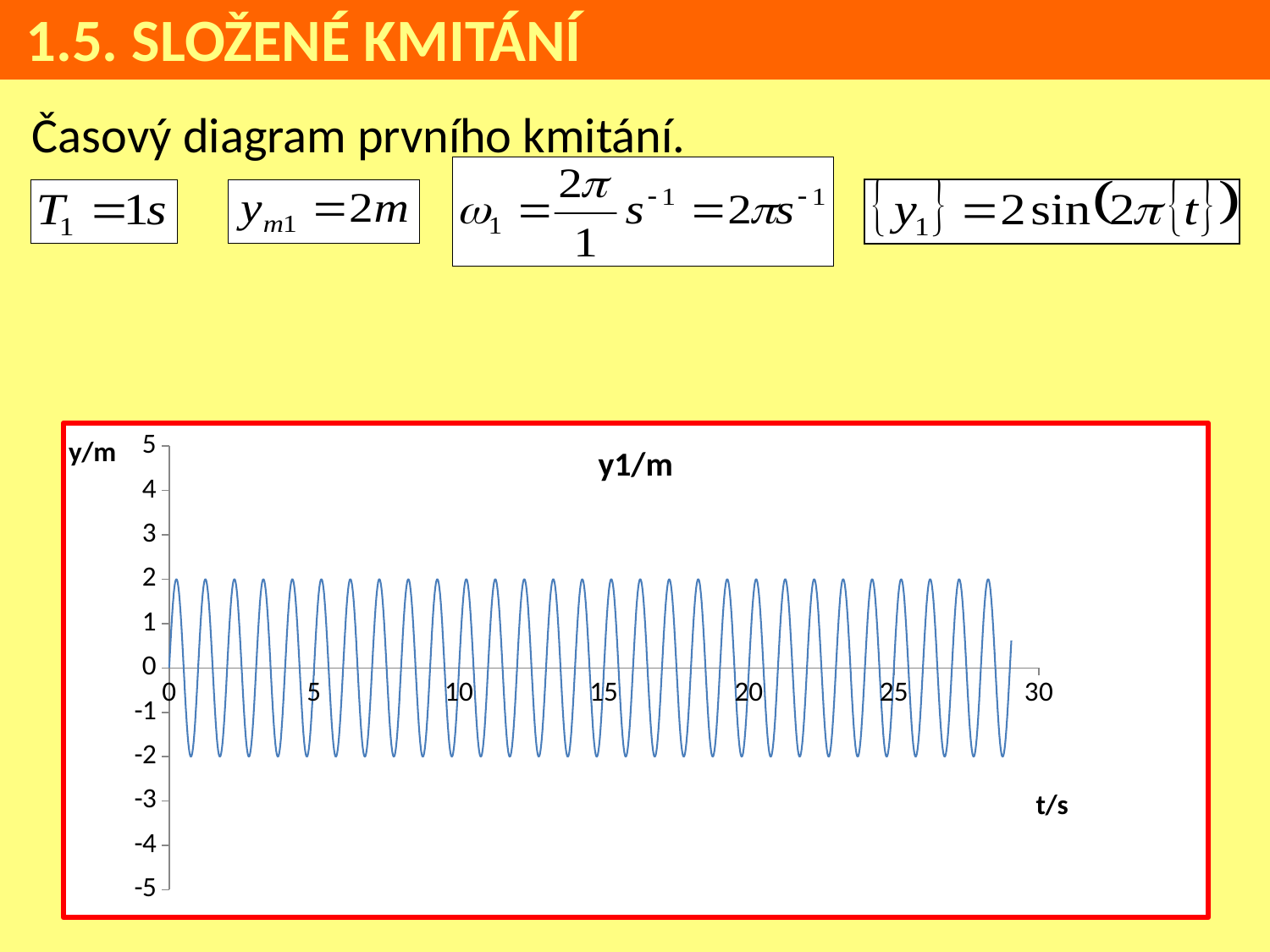
What kind of chart is shown on the slide? line chart What label is shown on the horizontal axis of the chart? t/s Is the peak value of the plotted line greater or less than 1? greater Does the amplitude of the plotted oscillation rise, fall, or stay constant along the x axis? stay constant Is the peak value of the plotted line greater or less than 3? less What is the title of the chart? y1/m What is the lowest value the plotted line reaches on the y axis? -2 What is the highest tick value shown on the vertical axis? 5 What is the value of the plotted line at t = 0? 0 Is the lowest value of the plotted line greater or less than -3? greater What is the highest value the plotted line reaches on the y axis? 2 What is the highest tick value shown on the horizontal axis? 30